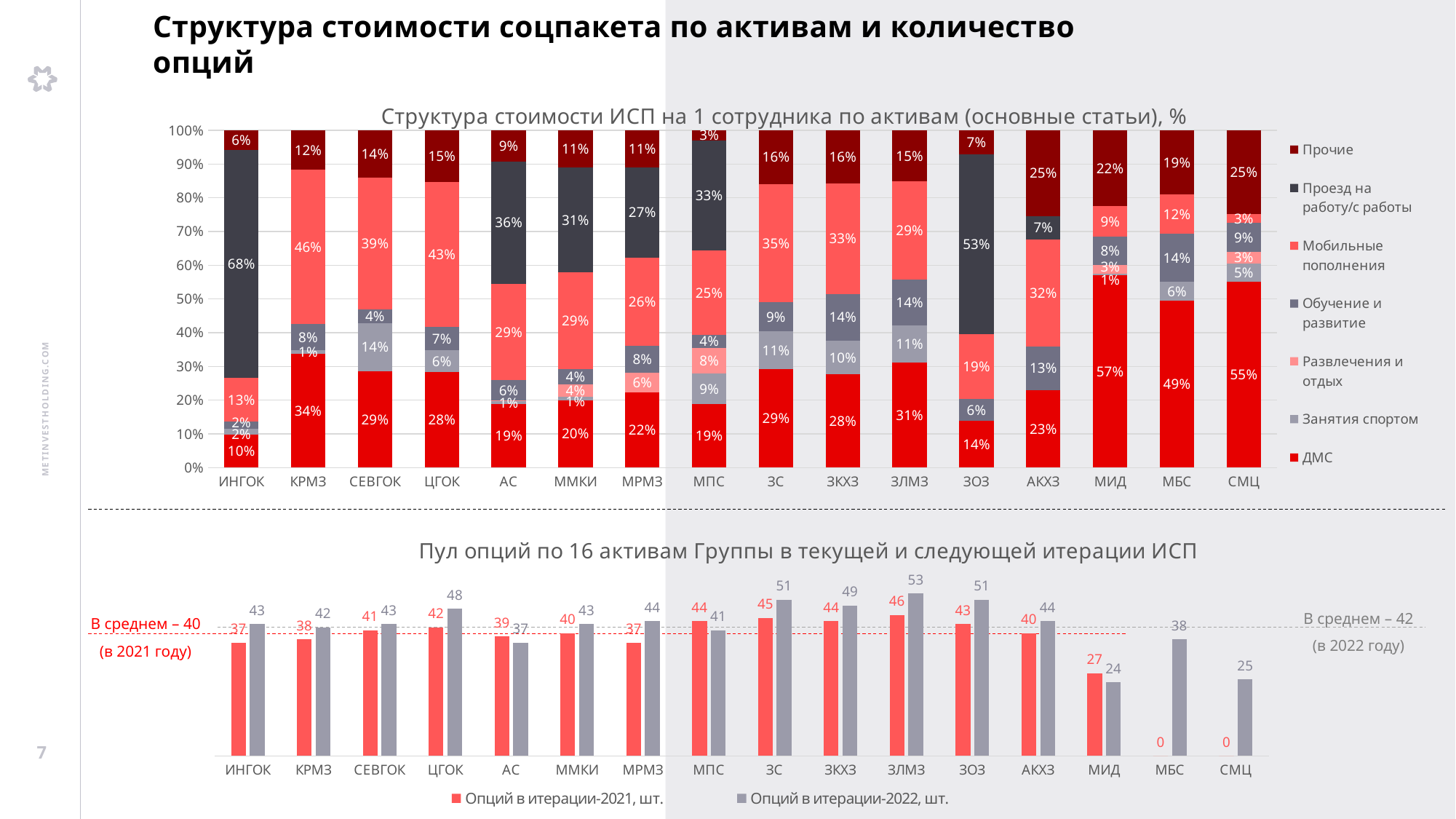
In the bottom chart 'Пул опций по 16 активам Группы', what is the difference between the 2022 and 2021 option counts for МБС? 38 In the bottom chart 'Пул опций по 16 активам Группы', how many options did ЗЛМЗ have in the 2022 iteration? 53 What type of chart is the bottom chart 'Пул опций по 16 активам Группы'? Bar chart In the top chart 'Структура стоимости ИСП на 1 сотрудника по активам', what is the share of ДМС for МИД? 57% In the top chart 'Структура стоимости ИСП на 1 сотрудника по активам', which asset has the highest ДМС share? МИД In the bottom chart 'Пул опций по 16 активам Группы', how many assets are shown on the x axis? 16 In the bottom chart 'Пул опций по 16 активам Группы', which is larger for МПС: options in the 2021 iteration or in the 2022 iteration? 2021 iteration In the bottom chart 'Пул опций по 16 активам Группы', which asset has the highest number of options in the 2022 iteration? ЗЛМЗ In the top chart 'Структура стоимости ИСП на 1 сотрудника по активам', which asset has the lowest ДМС share? ИНГОК In the top chart 'Структура стоимости ИСП на 1 сотрудника по активам', what is the share of 'Проезд на работу/с работы' for ИНГОК? 68% In the top chart 'Структура стоимости ИСП на 1 сотрудника по активам', how many series does the legend list? 7 In the top chart 'Структура стоимости ИСП на 1 сотрудника по активам', what is the difference between the 'Мобильные пополнения' share for КРМЗ and for ЦГОК? 3%